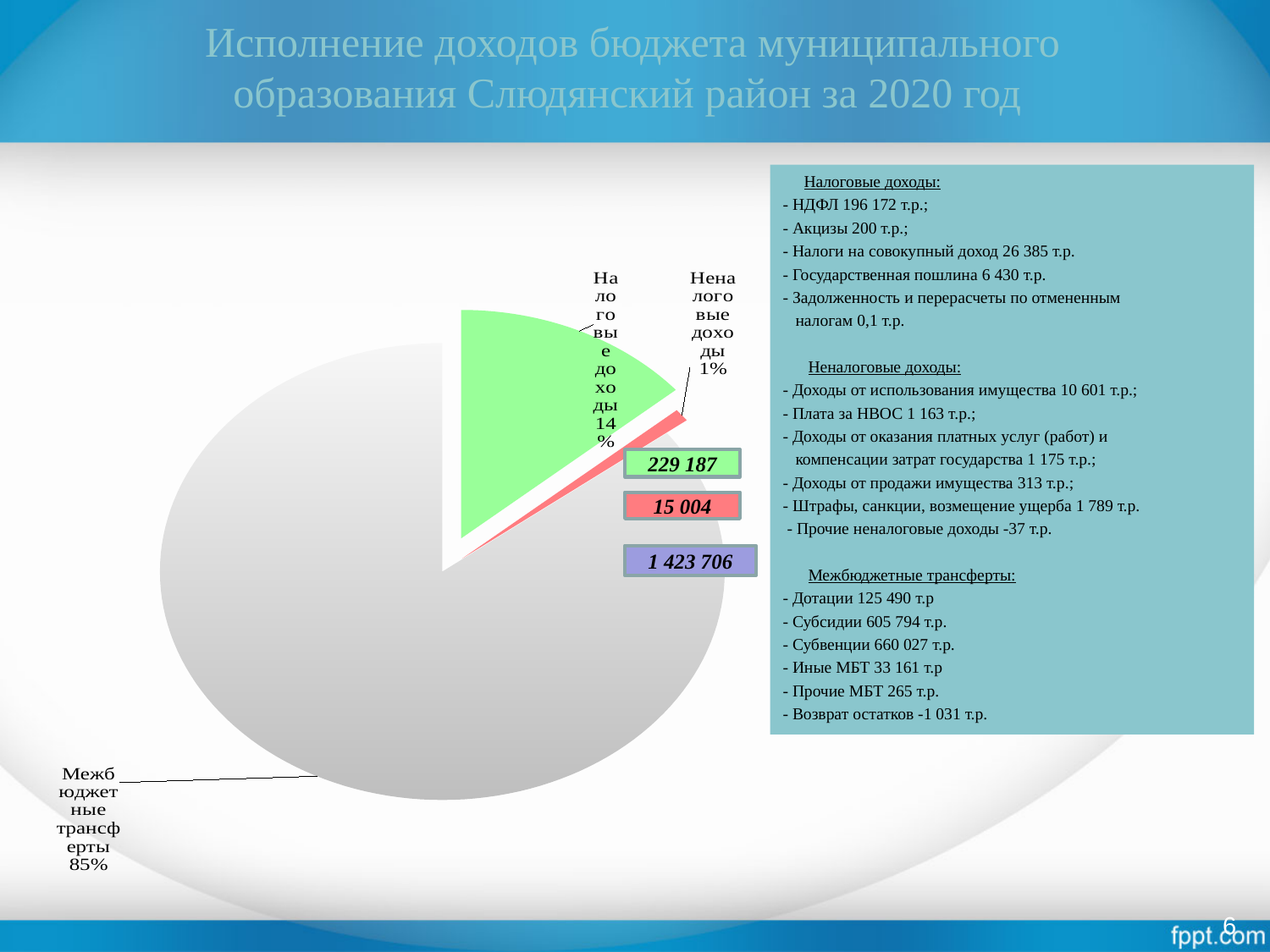
What value is shown in the box for Межбюджетные трансферты? 1 423 706 Which is larger: the slice for Налоговые доходы or the slice for Неналоговые доходы? Налоговые доходы Which category has the smallest slice of the pie? Неналоговые доходы What share of the pie does Налоговые доходы take? 14% What value is shown in the green box for Налоговые доходы? 229 187 How many slices does the pie chart have? 3 What share of the pie does Межбюджетные трансферты take? 85% What type of chart is shown on the slide? pie chart What value is shown in the red box for Неналоговые доходы? 15 004 By how many percentage points does the share of Межбюджетные трансферты exceed the share of Налоговые доходы? 71 Which category has the largest slice of the pie? Межбюджетные трансферты What share of the pie does Неналоговые доходы take? 1%